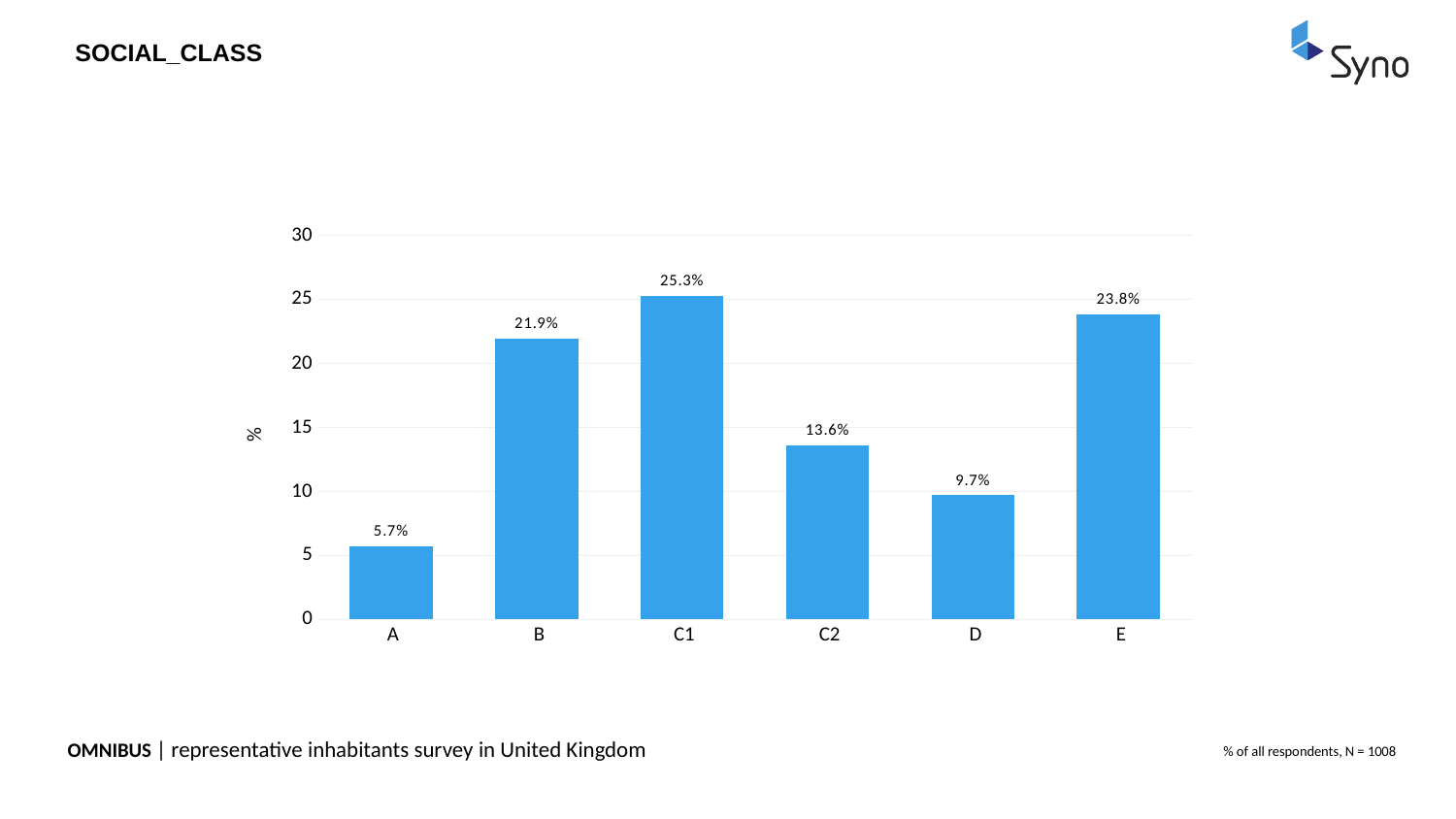
What is the value for social class C1? 25.3% What is the difference between the values for B and C2? 8.3% Which is larger, the value for E or the value for B? E How many social class categories are shown on the x axis? 6 What is the label on the y axis? % What is the value for social class A? 5.7% Which social class has the lowest value? A What is the difference between the values for C1 and E? 1.5% What kind of chart is shown on the slide? bar chart Is the value for C2 greater or less than 15? less Which social class has the highest value? C1 What is the value for social class D? 9.7%